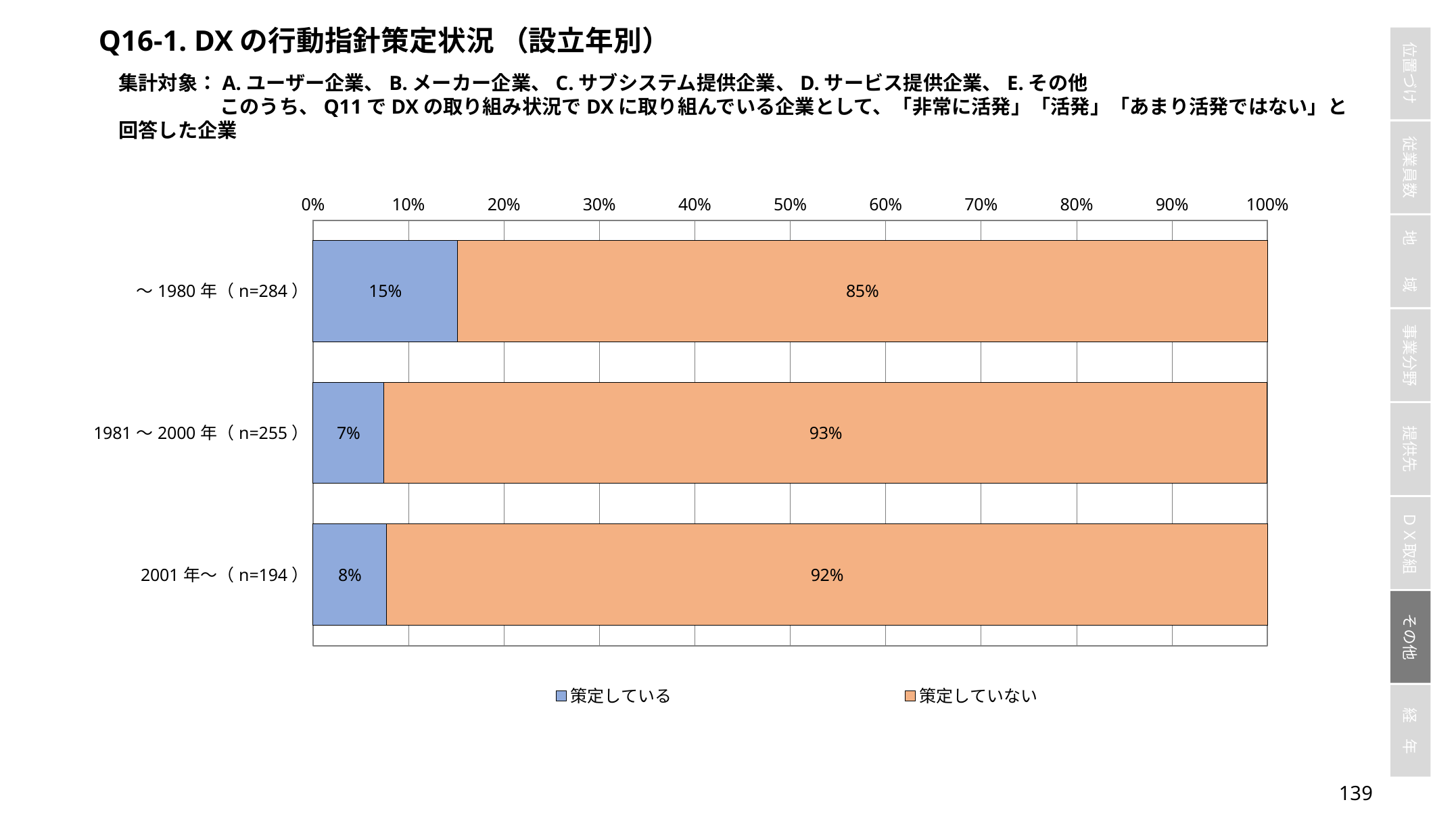
Is the 策定していない value for ～1980年 greater or less than 80%? greater What percentage of companies established 1981～2000年 answered 策定していない? 93% What is the difference in percentage points between the 策定している share for ～1980年 and for 2001年～? 7 Which group has a larger 策定していない share, 1981～2000年 or ～1980年? 1981～2000年 How many establishment-year groups are shown in the chart? 3 What percentage of companies established 2001年～ answered 策定している? 8% Which establishment-year group has the lowest share of 策定している? 1981～2000年 What is the sample size (n) for the 2001年～ group? 194 Which establishment-year group has the highest share of 策定している? ～1980年 How many series does the legend list? 2 What percentage of companies established in or before 1980 (～1980年) answered 策定している? 15% What kind of chart is shown on the slide? Stacked bar chart